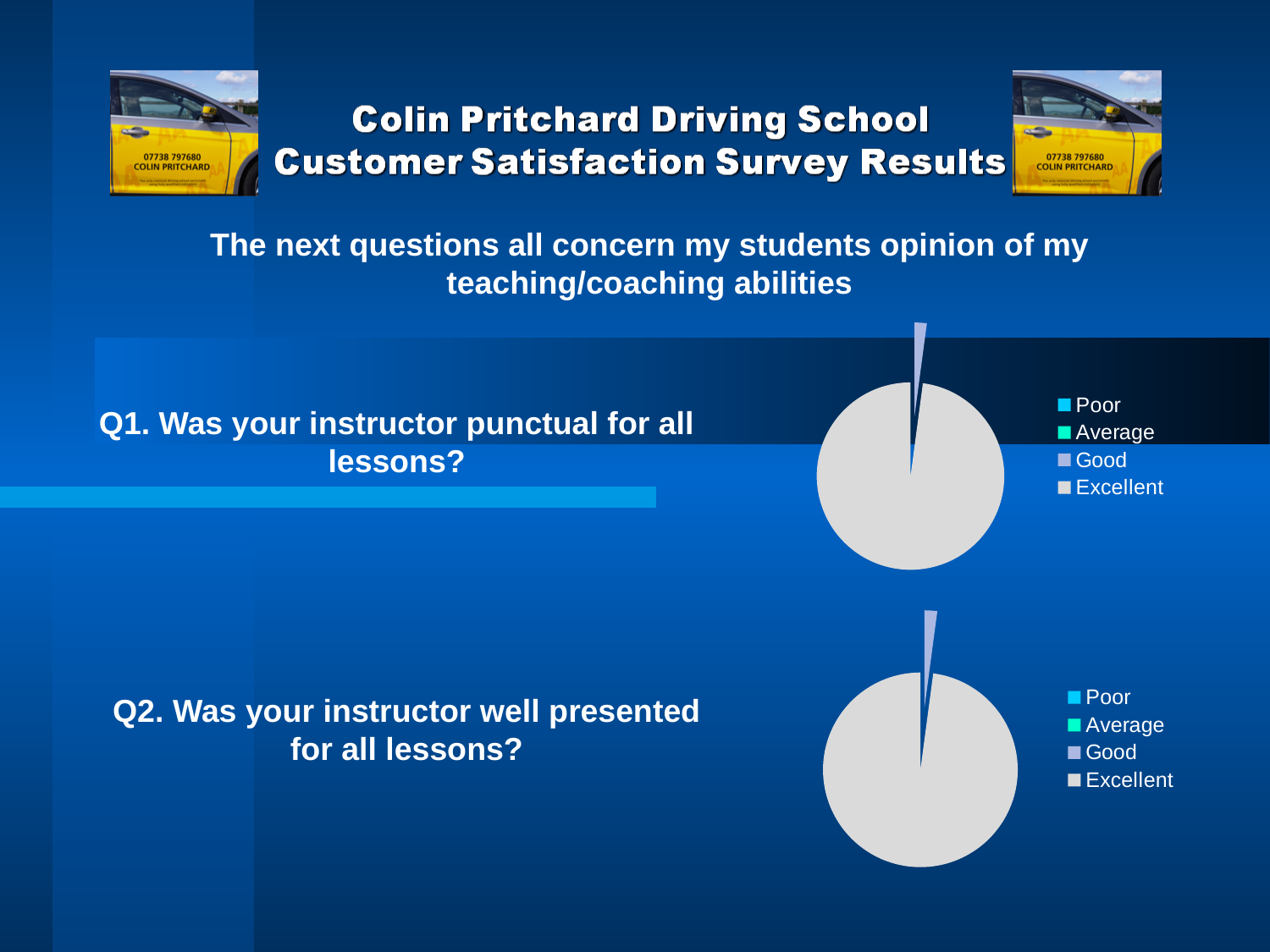
In the pie chart for Q2 (well presented for all lessons), which slice is larger, Good or Excellent? Excellent What are the legend entries of the Q1 pie chart, in order? Poor, Average, Good, Excellent How many entries does the legend of the Q1 pie chart list? 4 In the pie chart for Q1 (punctual for all lessons), which category has the largest slice? Excellent In the pie chart for Q1 (punctual for all lessons), which slice is larger, Excellent or Good? Excellent What kind of chart is shown next to Q2 (Was your instructor well presented for all lessons?)? pie chart In the pie chart for Q2 (well presented for all lessons), which category is represented by the small lavender slice? Good What kind of chart is shown next to Q1 (Was your instructor punctual for all lessons?)? pie chart In the pie chart for Q2 (well presented for all lessons), which category has the largest slice? Excellent How many entries does the legend of the Q2 pie chart list? 4